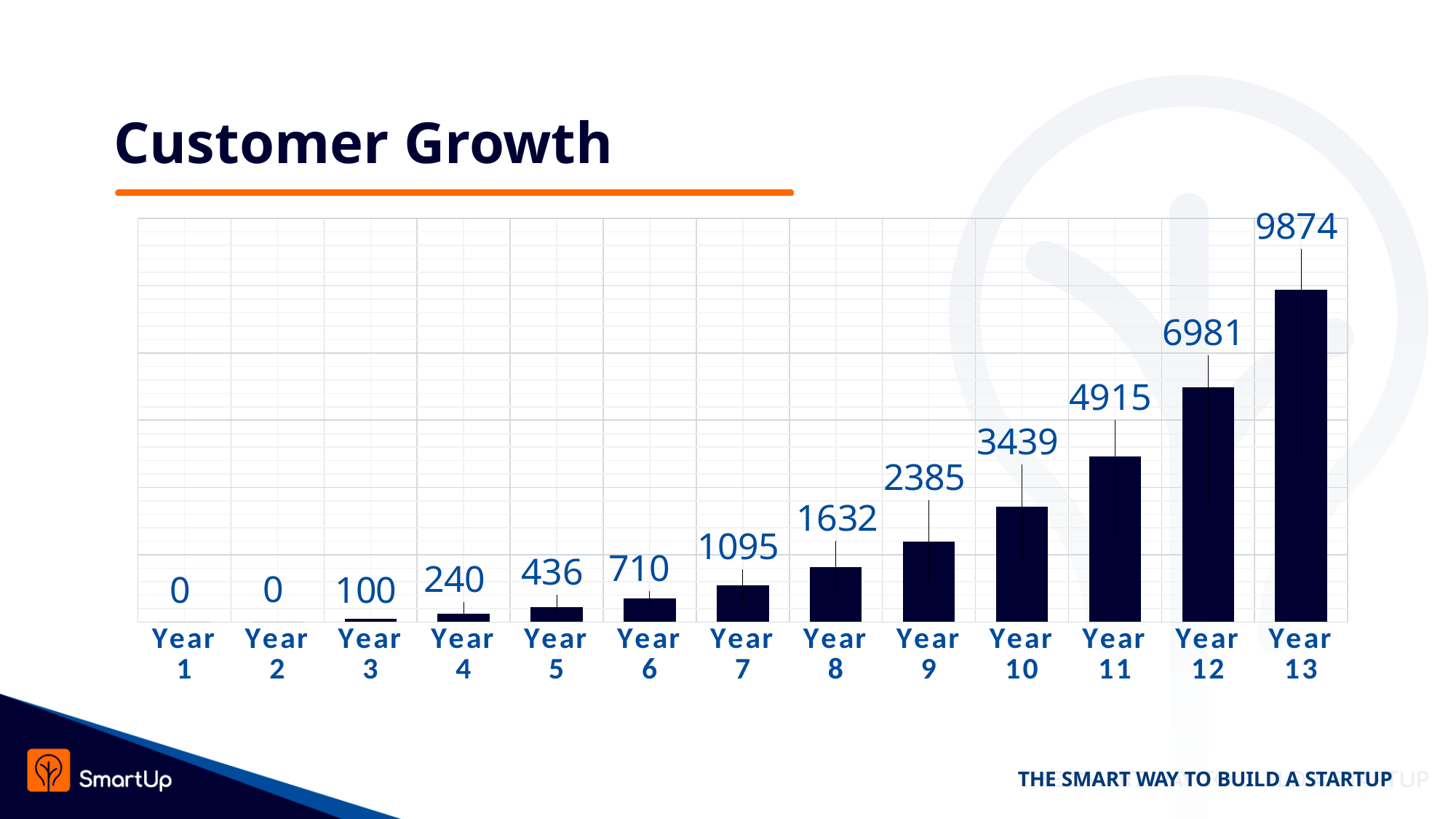
What is the value for Year 4? 240 What is the difference between the values for Year 13 and Year 12? 2893 What is the title of the slide? Customer Growth Do the values rise or fall from Year 3 to Year 13? Rise Which is larger, the value for Year 8 or the value for Year 6? Year 8 Which year has the highest value? Year 13 What is the value for Year 1? 0 What is the value for Year 13? 9874 How many years are shown on the x axis? 13 What is the difference between the values for Year 10 and Year 9? 1054 What kind of chart is shown on the slide? Bar chart What is the value for Year 7? 1095